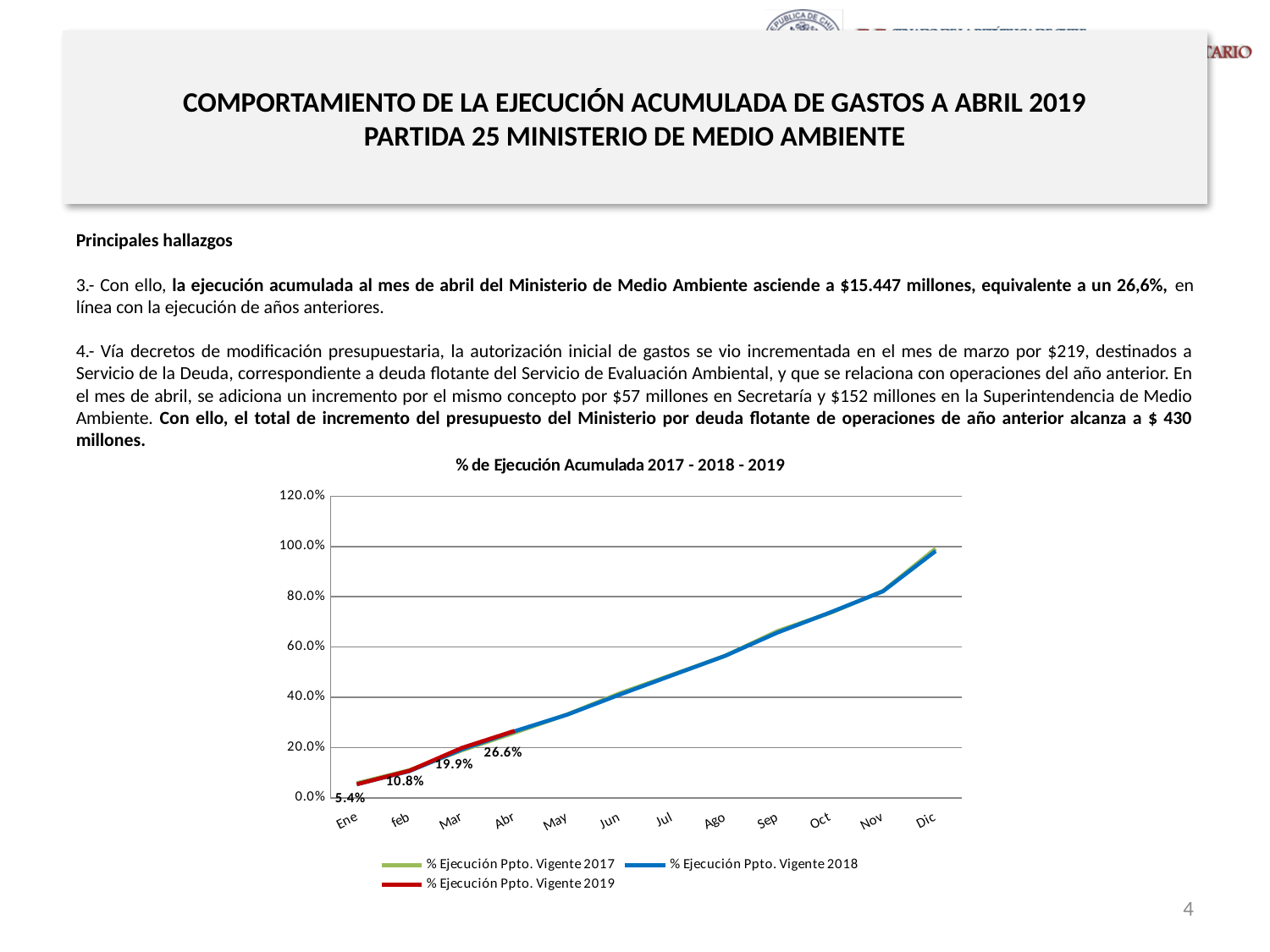
What is the difference between the Abr and Mar values in the % Ejecución Ppto. Vigente 2019 series? 6.7% What is the value for Mar in the % Ejecución Ppto. Vigente 2019 series? 19.9% Is the value for Jun in the % Ejecución Ppto. Vigente 2018 series greater or less than 60.0%? less What kind of chart is shown on the slide? line chart How many series does the chart legend list? 3 What is the value for Abr in the % Ejecución Ppto. Vigente 2019 series? 26.6% What is the value for Ene in the % Ejecución Ppto. Vigente 2019 series? 5.4% What is the value for Feb in the % Ejecución Ppto. Vigente 2019 series? 10.8% How many months are shown on the x axis of the chart? 12 What is the title of the chart? % de Ejecución Acumulada 2017 - 2018 - 2019 Which month has the highest value in the % Ejecución Ppto. Vigente 2019 series? Abr Do the values of the % Ejecución Ppto. Vigente 2018 series rise or fall from Ene to Dic? rise